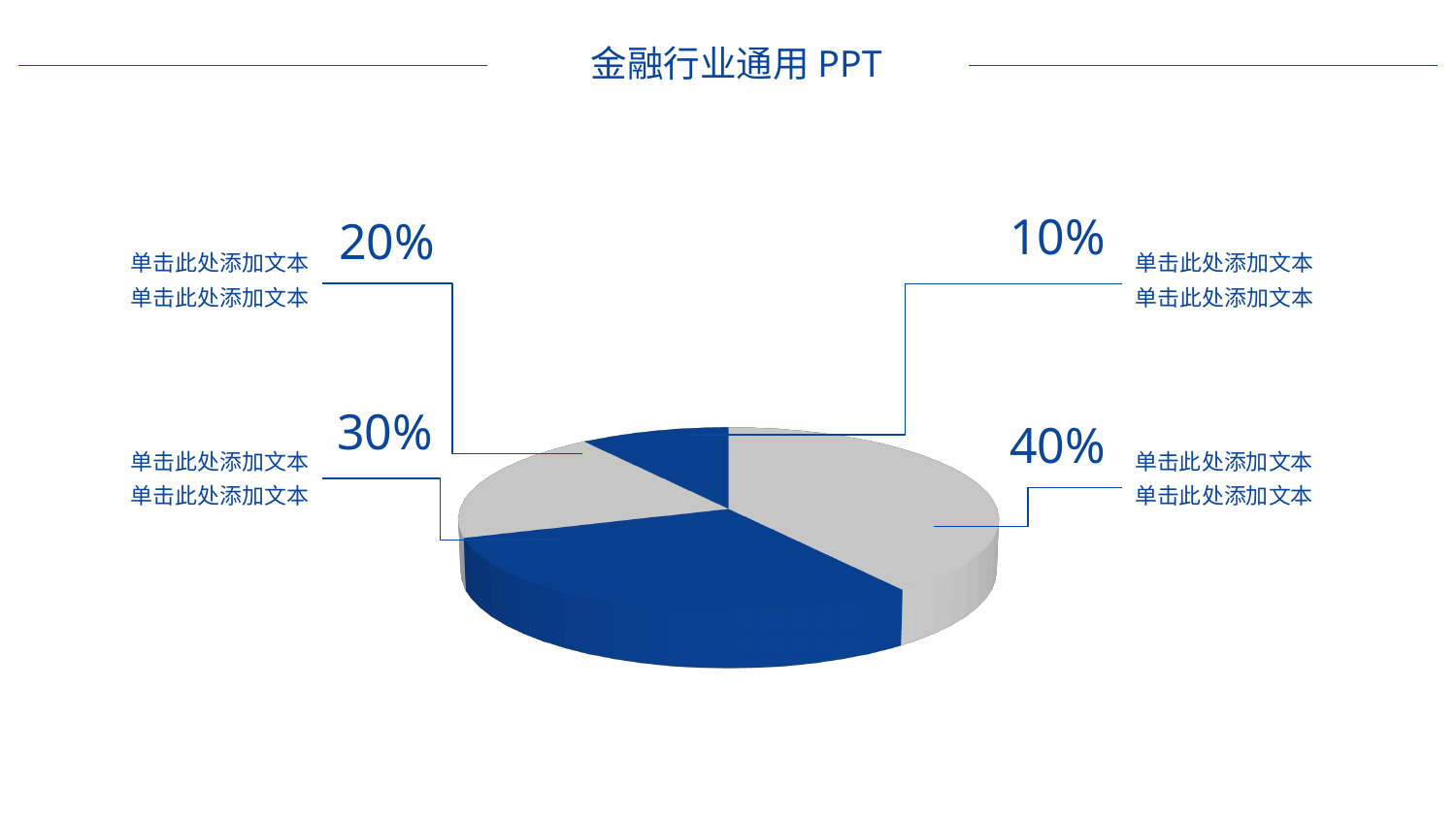
What is the percentage of the second-largest slice on the pie chart? 30% What kind of chart is shown on the slide? pie chart What two colours are used for the slices of the pie chart? blue and grey How many slices does the pie chart have? 4 What is the smallest percentage labelled on the pie chart? 10% What do the four percentage labels on the pie chart add up to? 100% Which is larger, the slice labelled 40% or the slice labelled 30%? 40% What is the largest percentage labelled on the pie chart? 40% What is the difference between the 30% slice and the 20% slice? 10 percentage points What is the title shown at the top of the slide? 金融行业通用 PPT What is the difference between the largest and smallest slice percentages on the pie chart? 30 percentage points